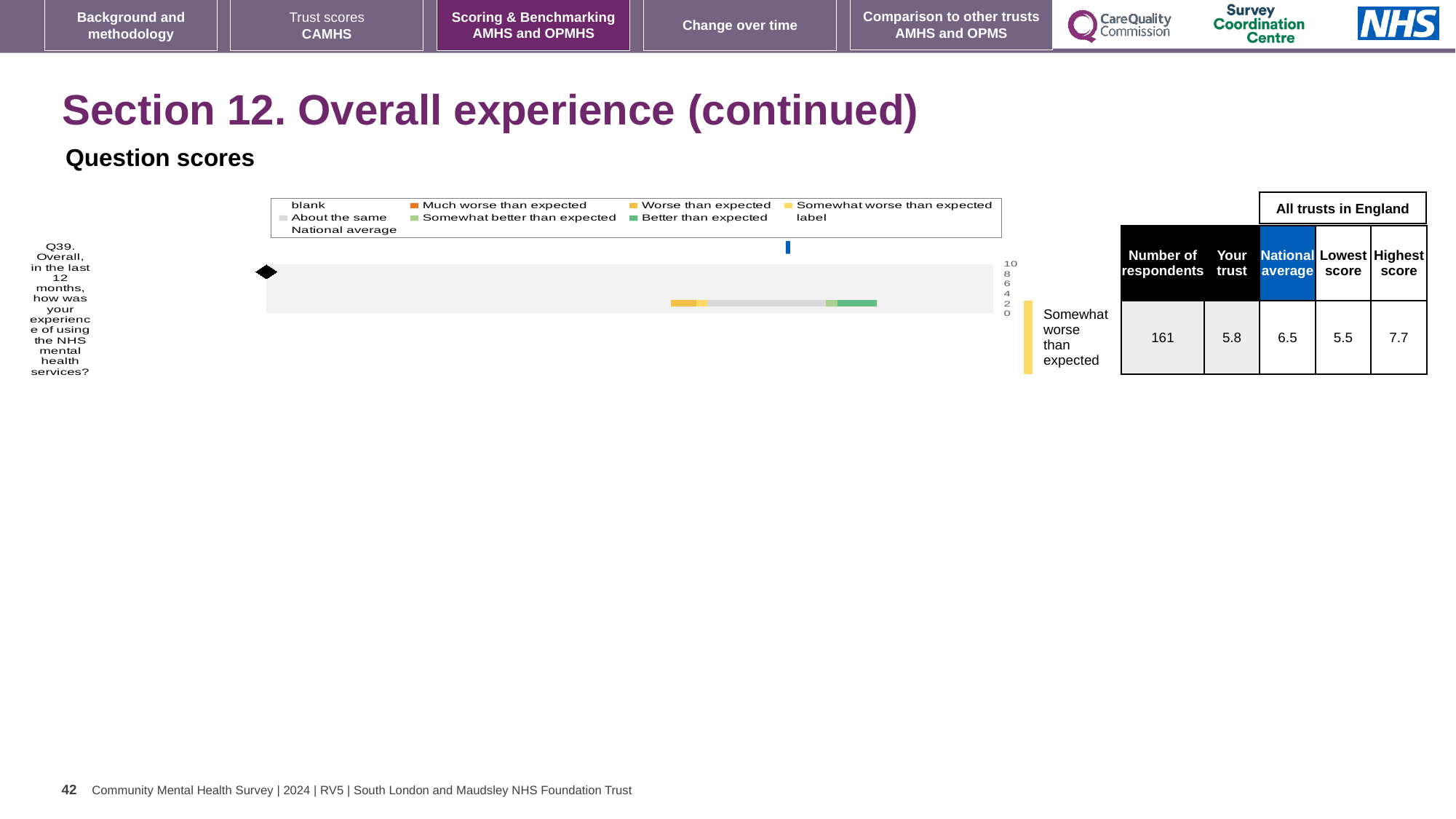
What is the highest score among all trusts in England for Q39? 7.7 What is the difference between the highest and lowest trust scores for Q39? 2.2 What kind of chart is used to show the Q39 score? Bar chart What is the national average score for Q39? 6.5 What is the 'Your trust' score for Q39 (overall experience of using NHS mental health services)? 5.8 By how much is the national average above the trust's score for Q39? 0.7 Which is larger for Q39, the trust's score or the national average? National average Is the trust's score for Q39 greater or less than 6? less What is the lowest score among all trusts in England for Q39? 5.5 How many questions are plotted on the chart? 1 How many respondents answered Q39? 161 Which benchmark category is the trust's Q39 score placed in? Somewhat worse than expected